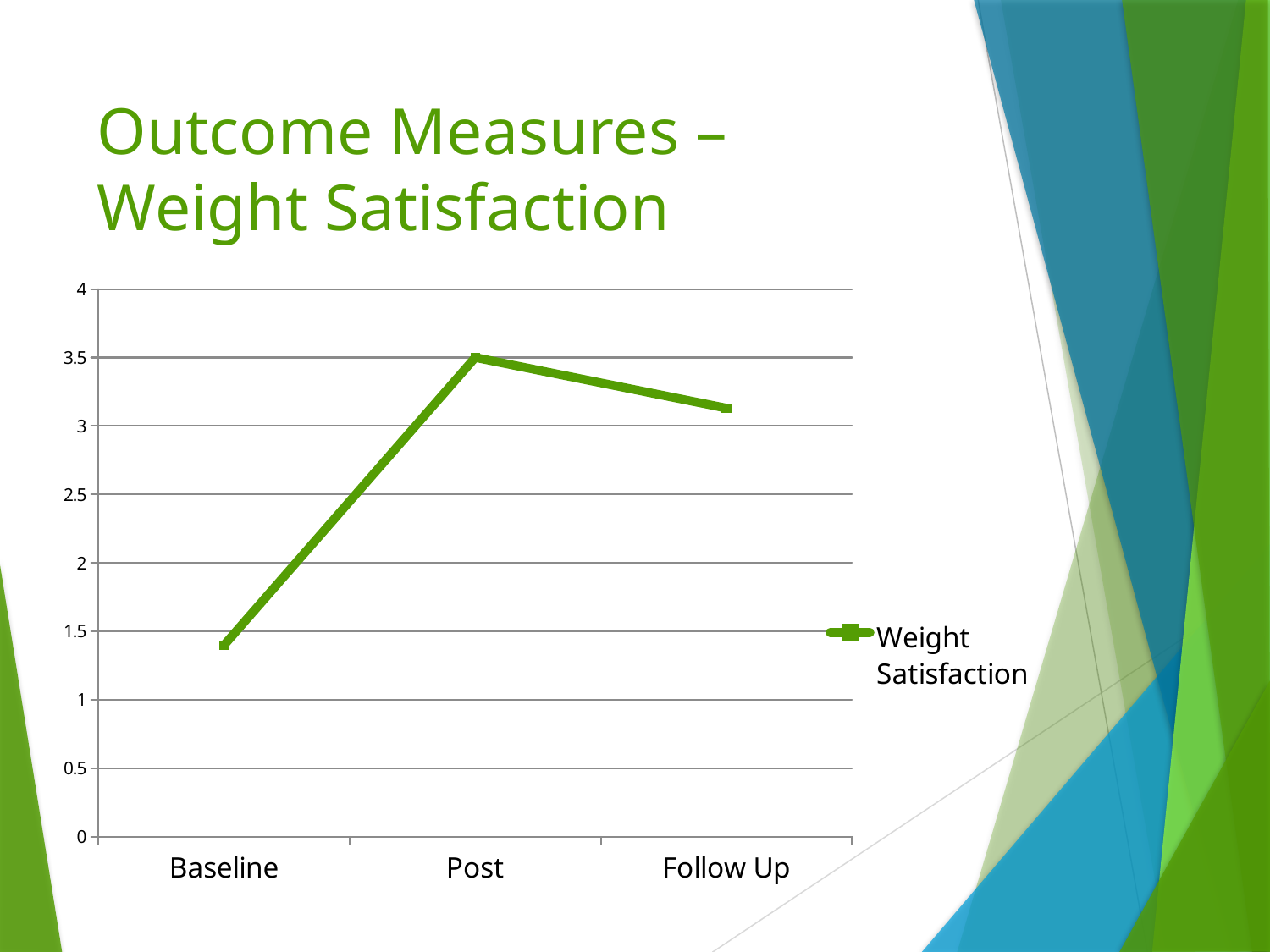
Which category has the lowest Weight Satisfaction value? Baseline What kind of chart is shown on the slide? line chart Is the Weight Satisfaction value at Baseline greater or less than 1? greater Is the Weight Satisfaction value at Follow Up greater or less than 3? greater How many points are plotted along the x axis? 3 Which category has the highest Weight Satisfaction value? Post How many series does the legend list? 1 Is the Weight Satisfaction value at Post greater or less than 3? greater Which is larger, the Weight Satisfaction value at Post or at Follow Up? Post Does the Weight Satisfaction value rise or fall from Baseline to Post? rise What series name is shown in the legend? Weight Satisfaction